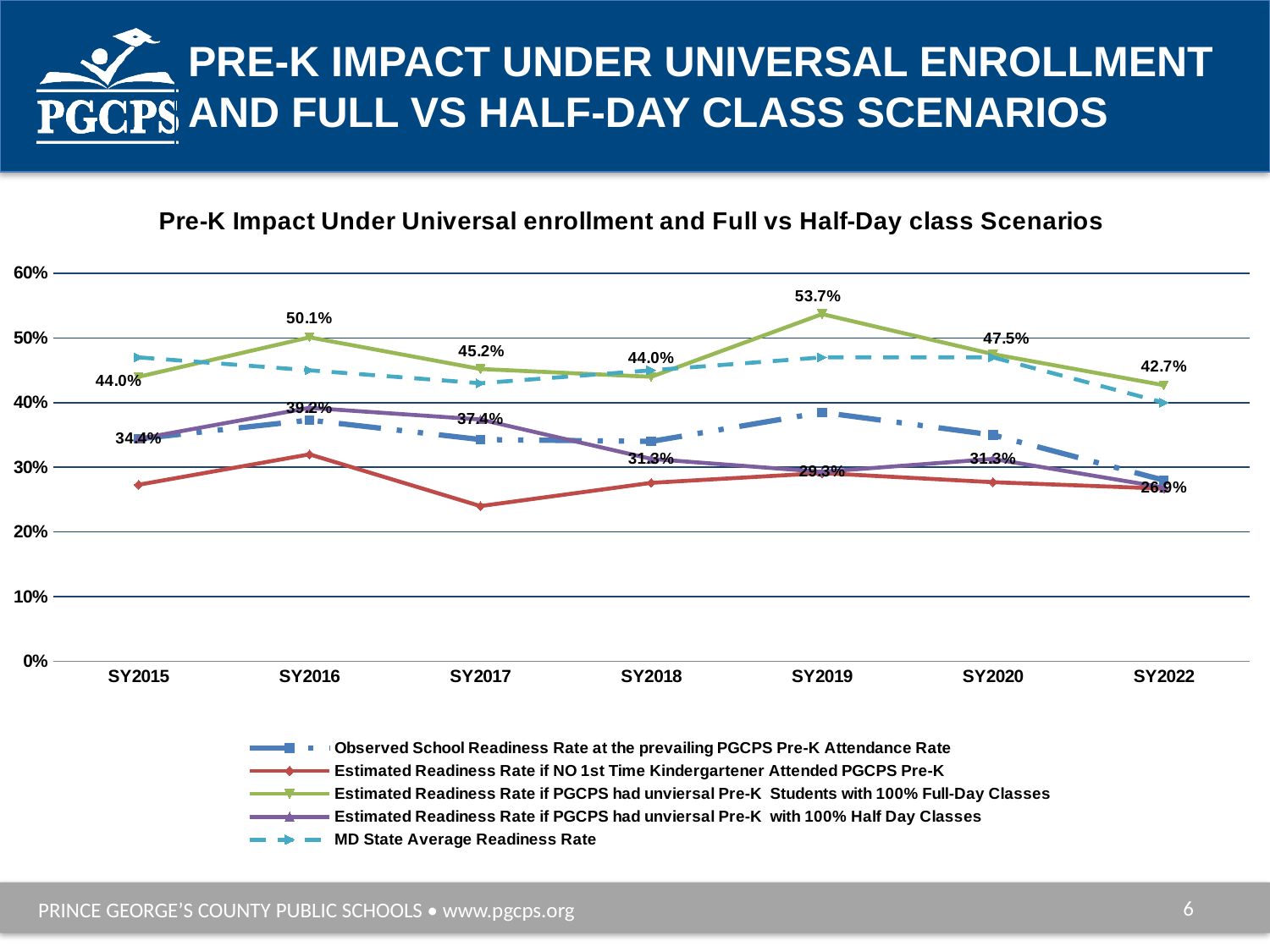
Is the Estimated Readiness Rate if NO 1st Time Kindergartener Attended PGCPS Pre-K for SY2017 greater or less than 30%? less Which legend entry is drawn as the light blue dashed line? MD State Average Readiness Rate For the 100% Half Day Classes estimate, which is larger: SY2016 or SY2017? SY2016 How many series does the chart's legend list? 5 In which school year is the Estimated Readiness Rate with 100% Full-Day Classes lowest? SY2022 What kind of chart is shown on the slide? Line chart What is the Estimated Readiness Rate if PGCPS had universal Pre-K with 100% Half Day Classes for SY2016? 39.2% By how many percentage points does the 100% Full-Day Classes estimate fall from SY2019 to SY2020? 6.2 percentage points How many school years are shown on the x axis of the chart? 7 What is the Estimated Readiness Rate if PGCPS had universal Pre-K with 100% Full-Day Classes for SY2019? 53.7% In which school year is the Estimated Readiness Rate with 100% Full-Day Classes highest? SY2019 Does the 100% Full-Day Classes estimate rise or fall from SY2019 to SY2022? Fall